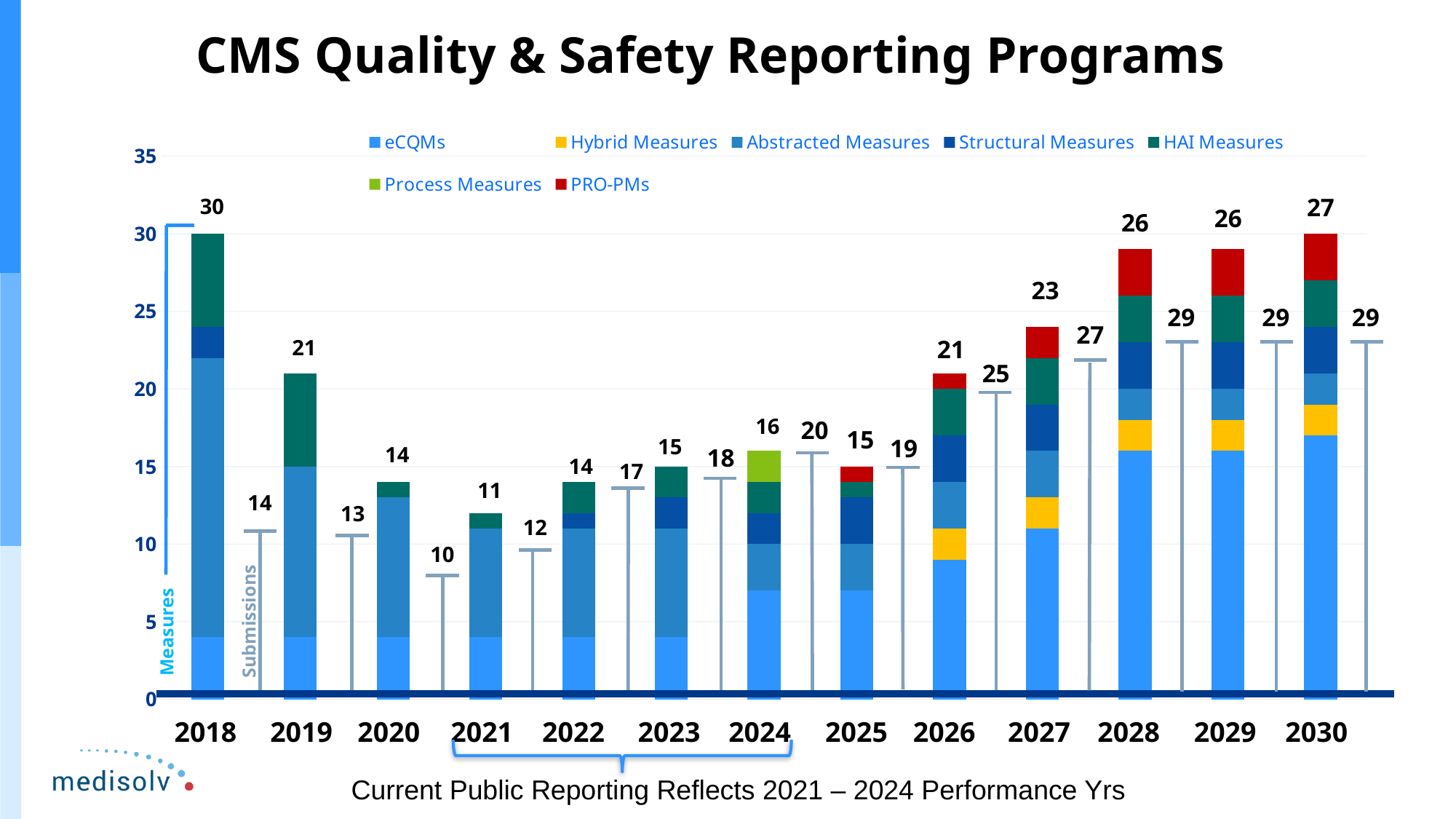
What colour represents Hybrid Measures in the legend? Yellow What kind of chart is shown on the slide? Stacked bar chart For 2027, which is larger: the labeled measures or the labeled submissions? Submissions Which year has the highest labeled number of measures? 2018 How many years are shown on the x axis? 13 What is the labeled number of submissions for 2024? 20 What is the difference between the labeled measures for 2018 and 2021? 19 Which year has the lowest labeled number of measures? 2021 What is the labeled number of submissions for 2020? 10 How many series does the legend list? 7 What is the labeled number of measures for 2018? 30 Do the labeled measures rise or fall from 2025 to 2030? Rise